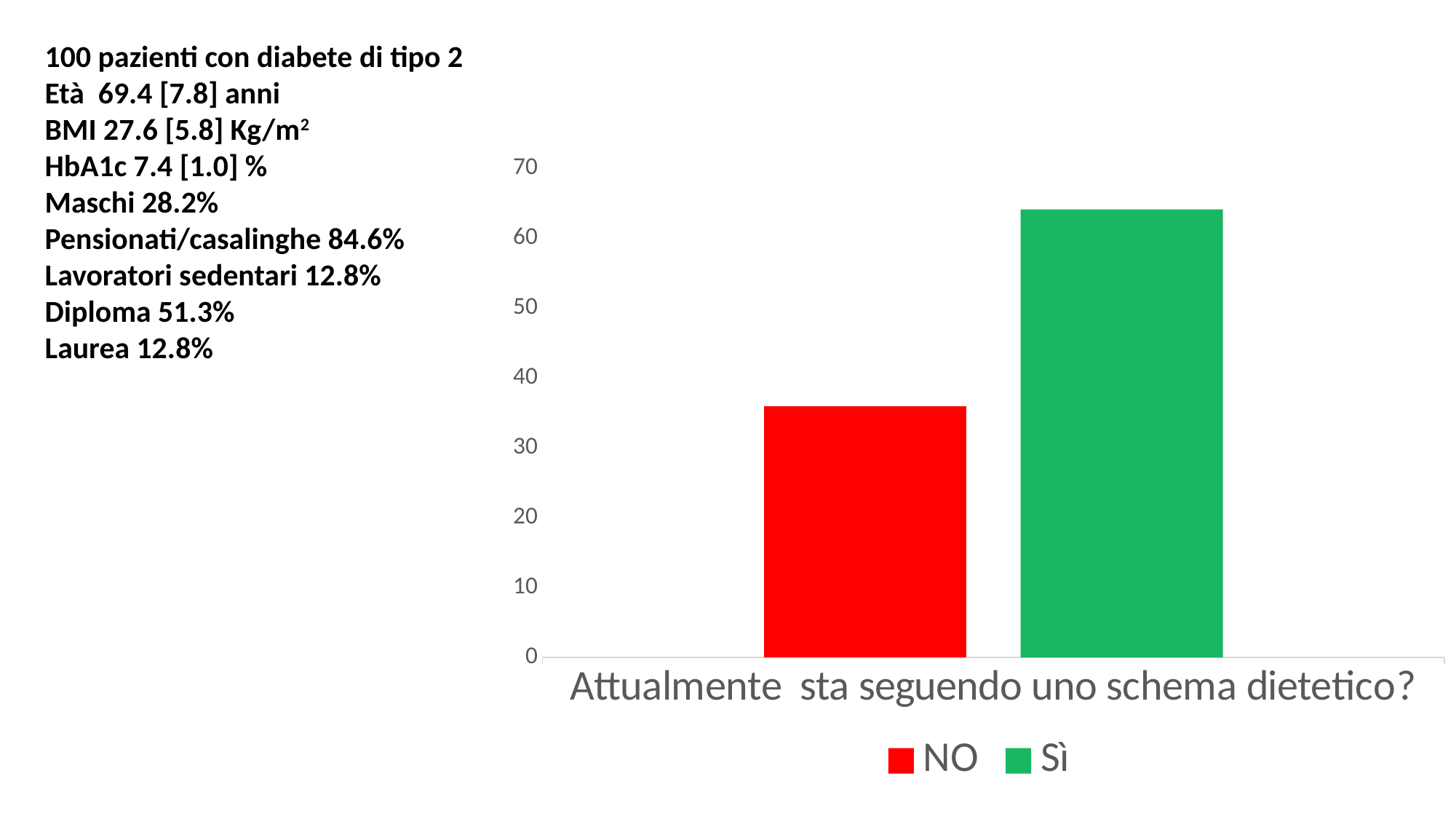
Is the value for NO greater or less than 40? less Which series has the taller bar, NO or Sì? Sì Which series has the shorter bar? NO What kind of chart is shown on the slide? bar chart Is the value for NO greater or less than 30? greater Is the value for Sì greater or less than 60? greater What question is written as the category label under the bars? Attualmente sta seguendo uno schema dietetico? What colour is the bar for the NO series? red How many bars are plotted in the chart? 2 How many series does the legend list? 2 Is the value for Sì larger than the value for NO? yes